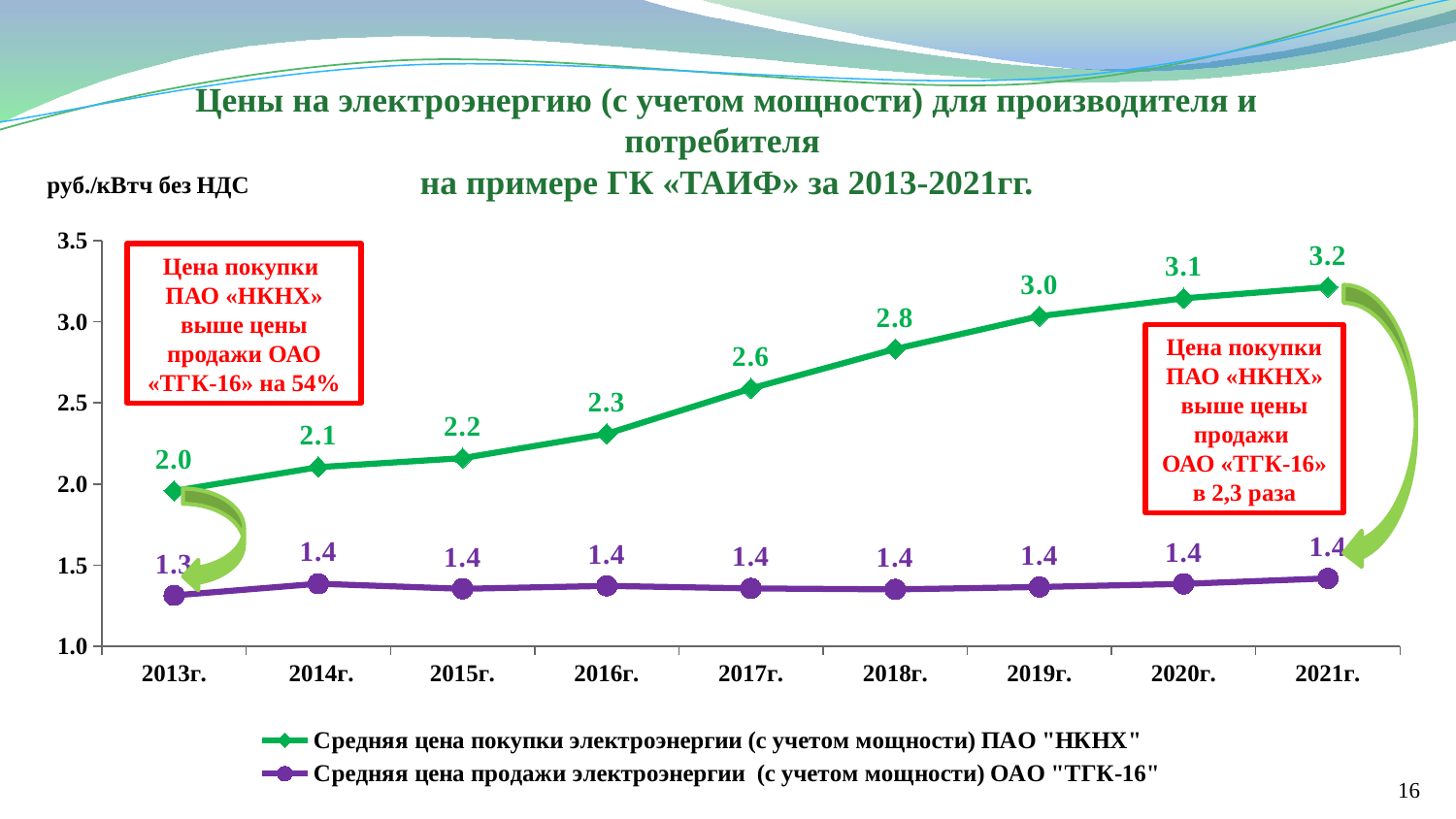
What is the difference between the ПАО «НКНХ» purchase price and the ОАО «ТГК-16» sale price in 2021г.? 1.8 How many years are shown on the x axis of the chart? 9 In which year was the sale price for ОАО «ТГК-16» the lowest? 2013г. What kind of chart is shown on the slide? Line chart What was the average sale price of electricity for ОАО «ТГК-16» in 2013г.? 1.3 How many series does the legend list? 2 Which was higher in 2019г.: the ПАО «НКНХ» purchase price or the ОАО «ТГК-16» sale price? ПАО «НКНХ» purchase price In which year was the purchase price for ПАО «НКНХ» the highest? 2021г. What was the average purchase price of electricity for ПАО «НКНХ» in 2017г.? 2.6 What was the average purchase price of electricity for ПАО «НКНХ» in 2021г.? 3.2 What was the average purchase price of electricity for ПАО «НКНХ» in 2013г.? 2.0 By how much did the ПАО «НКНХ» purchase price increase from 2013г. to 2021г.? 1.2